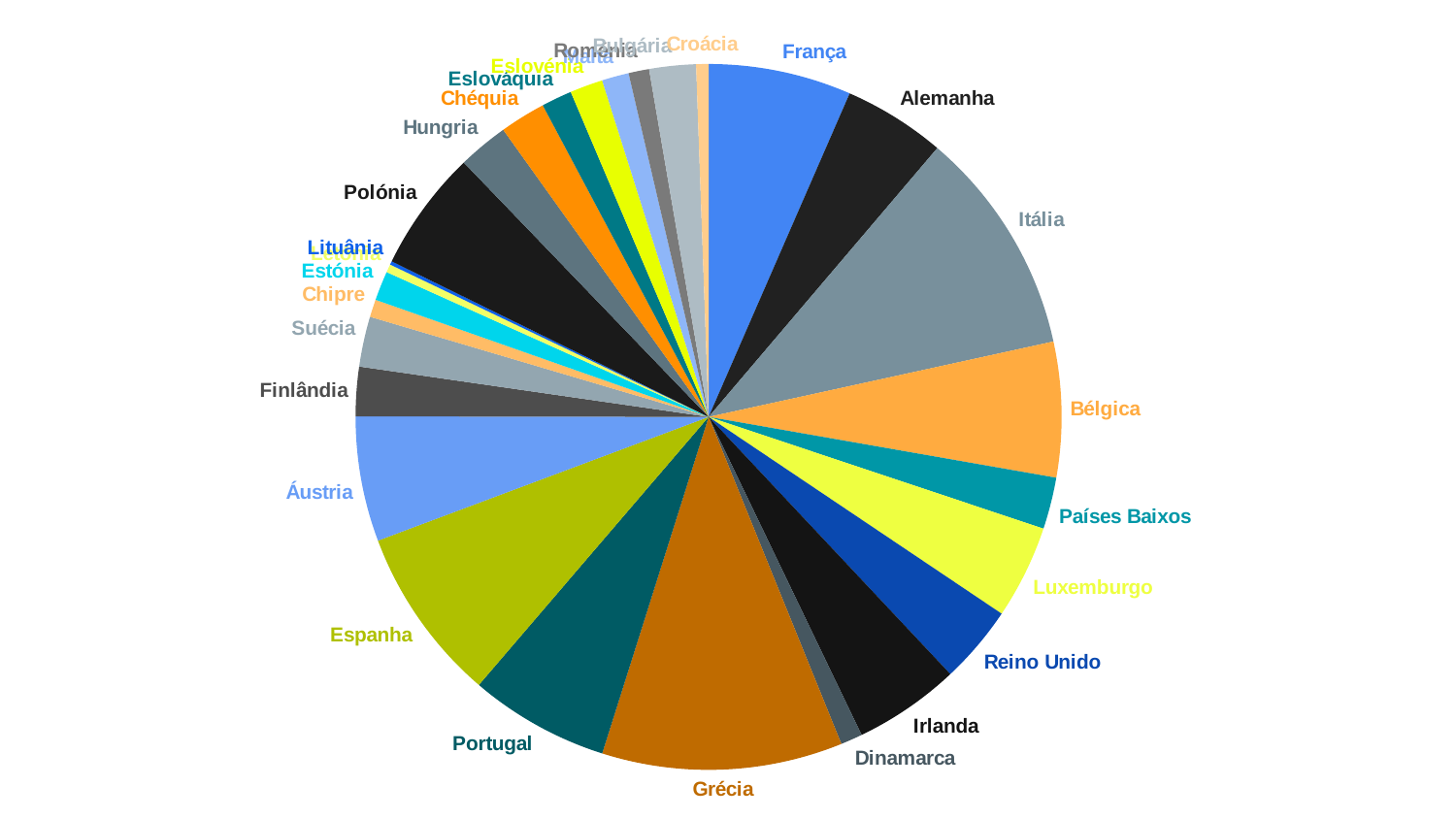
What kind of chart is shown on the slide? pie chart Which slice is larger, Reino Unido or Lituânia? Reino Unido Which slice is larger, Portugal or Hungria? Portugal Which slice is larger, Grécia or Dinamarca? Grécia What colour is the Bélgica slice? orange What colour is the Espanha slice? yellow-green